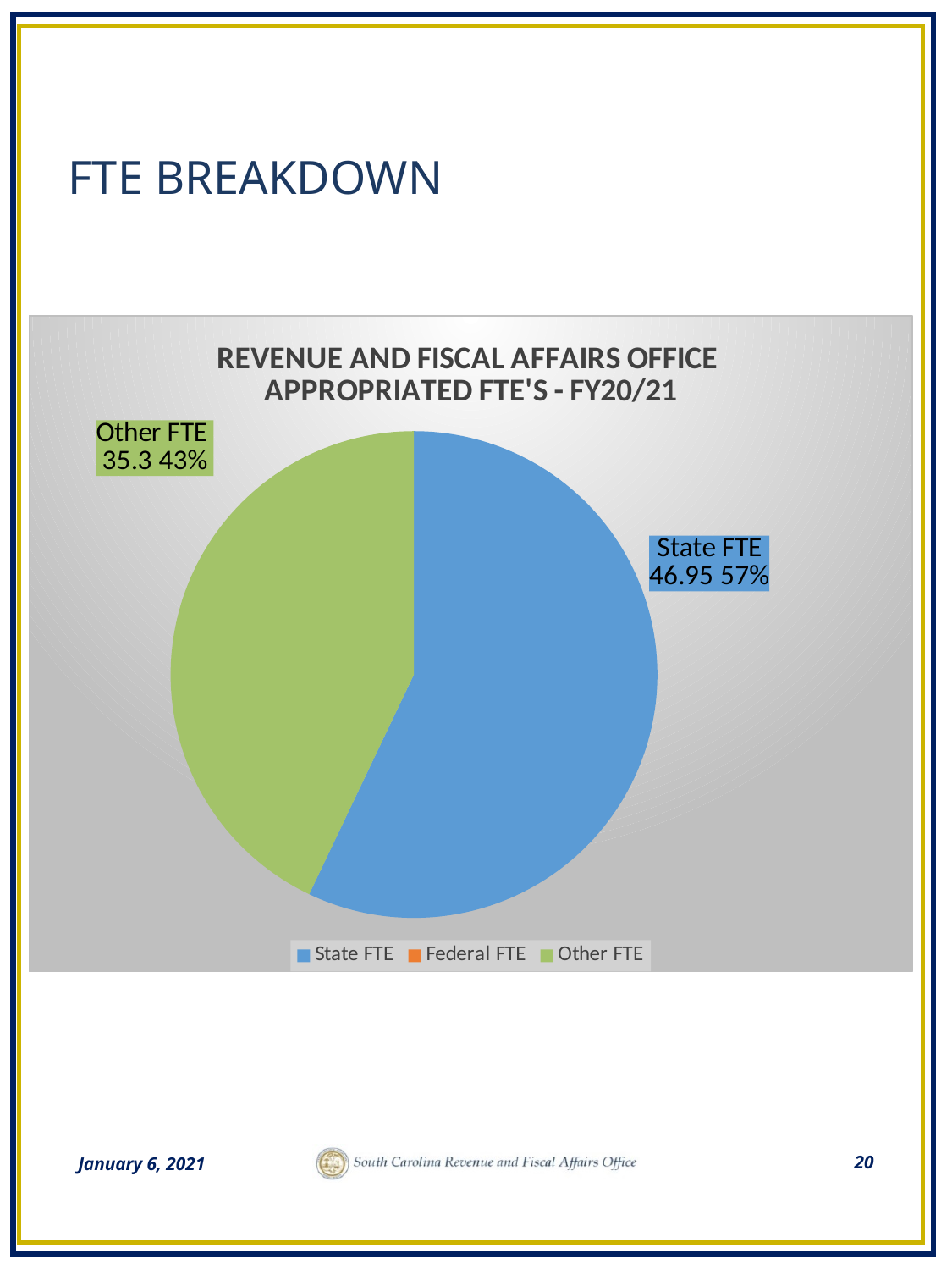
What is the value shown for State FTE? 46.95 Is the value for State FTE larger or smaller than the value for Other FTE? larger Which category has the largest slice of the pie? State FTE Which of the two labelled slices is smaller, State FTE or Other FTE? Other FTE What is the title of the chart? REVENUE AND FISCAL AFFAIRS OFFICE APPROPRIATED FTE'S - FY20/21 What is the difference between the State FTE value and the Other FTE value? 11.65 What share of the pie does State FTE represent? 57% What type of chart is shown on the slide? pie chart What is the value shown for Other FTE? 35.3 How many entries does the chart legend list? 3 What share of the pie does Other FTE represent? 43% What colour is the State FTE slice? blue